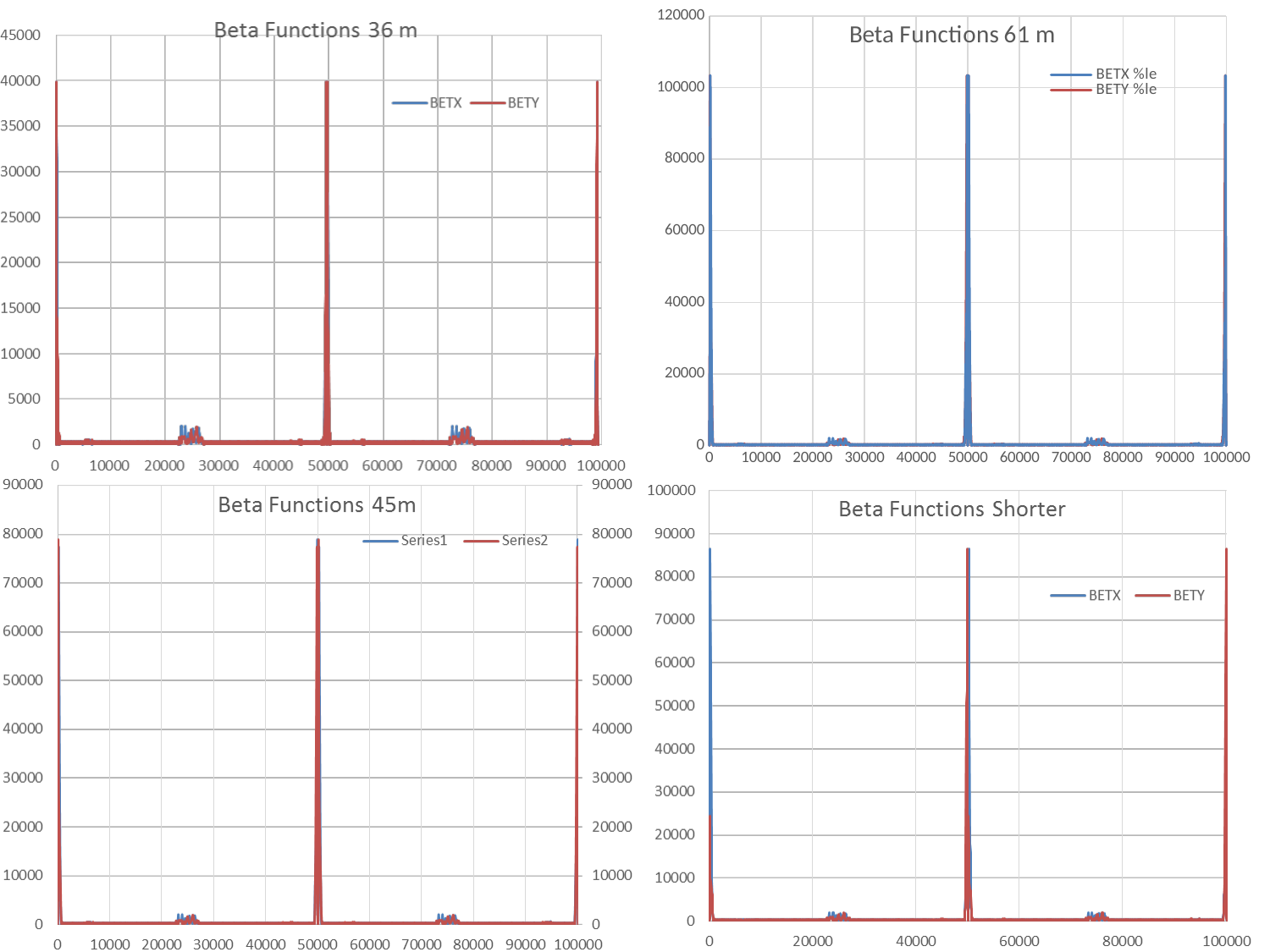
What are the legend entries in the "Beta Functions 45m" chart? Series1, Series2 How many series does the legend of "Beta Functions 61 m" list? 2 What kind of chart is "Beta Functions 36 m"? line chart What kind of chart is "Beta Functions 45m"? line chart In "Beta Functions 61 m", is the peak value near x = 50000 greater or less than 80000? greater In "Beta Functions 36 m", is the value at x = 30000 greater or less than 5000? less How many charts are shown on the slide? 4 In "Beta Functions 45m", is the peak value near x = 50000 greater or less than 70000? greater How many series does the legend of "Beta Functions Shorter" list? 2